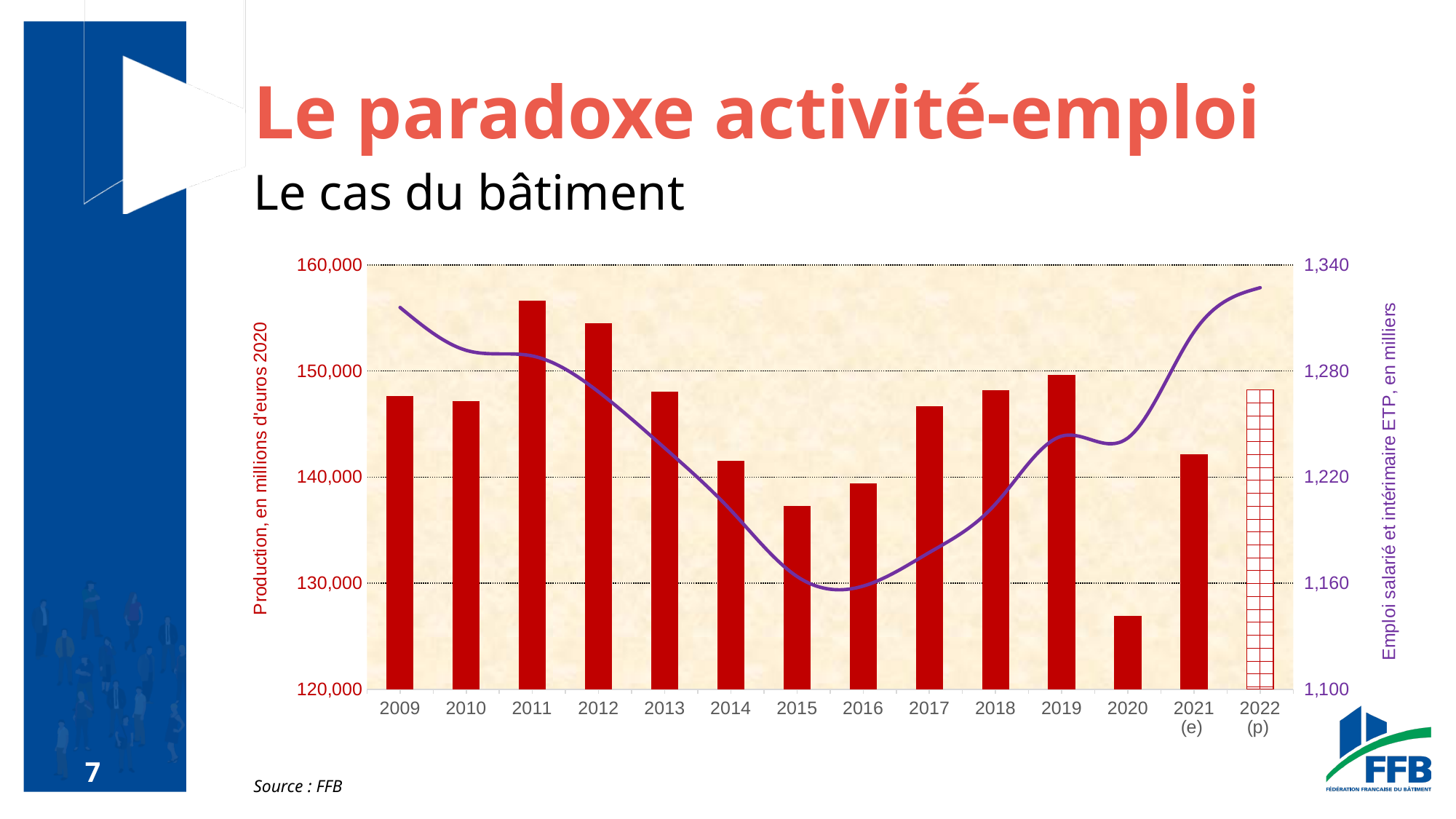
In which year does the employment line reach its highest point? 2022 (p) Which year has the highest production bar? 2011 Which year has a higher production bar, 2011 or 2012? 2011 Is the production value for 2011 greater or less than 150,000? greater Does the employment line rise or fall between 2009 and 2015? It falls Which year has the lowest production bar? 2020 Is the production value for 2020 greater or less than 130,000? less Is the production value for 2015 greater or less than 140,000? less What kind of chart is shown on the slide? A combined bar and line chart What is the title of the left vertical axis? Production, en millions d'euros 2020 How many years are shown on the x axis of the chart? 14